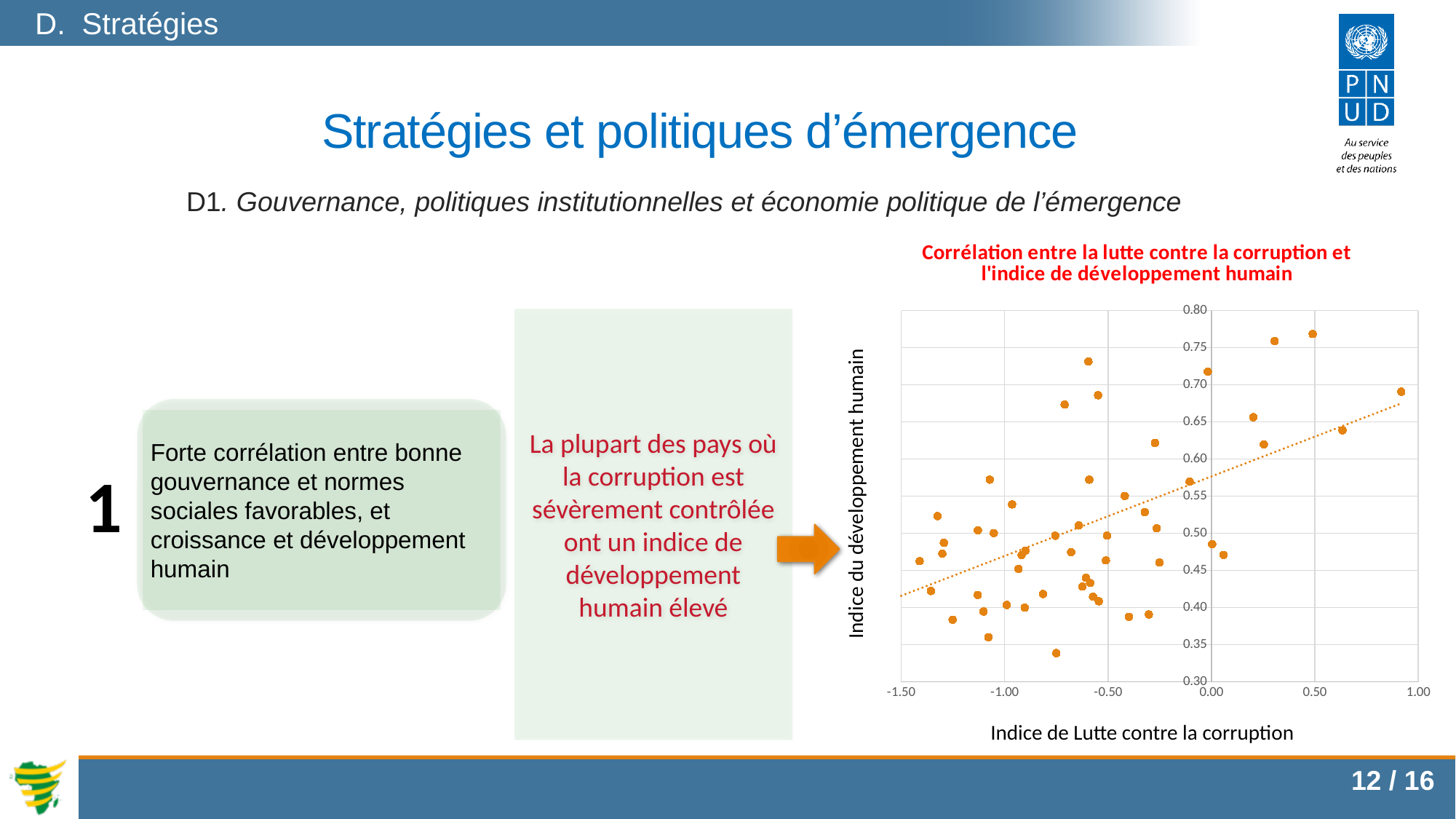
Is the lowest point on the chart greater or less than 0.35 on the y axis? less Is the highest point on the chart greater or less than 0.70 on the y axis? greater What is the label of the x axis of the chart? Indice de Lutte contre la corruption As the x-axis value (Indice de Lutte contre la corruption) increases, does the dotted trend line rise or fall? rise Is the point with the highest x value (near 1.00) greater or less than 0.65 on the y axis? greater What kind of chart is shown on the slide? scatter chart What is the title of the chart? Corrélation entre la lutte contre la corruption et l'indice de développement humain